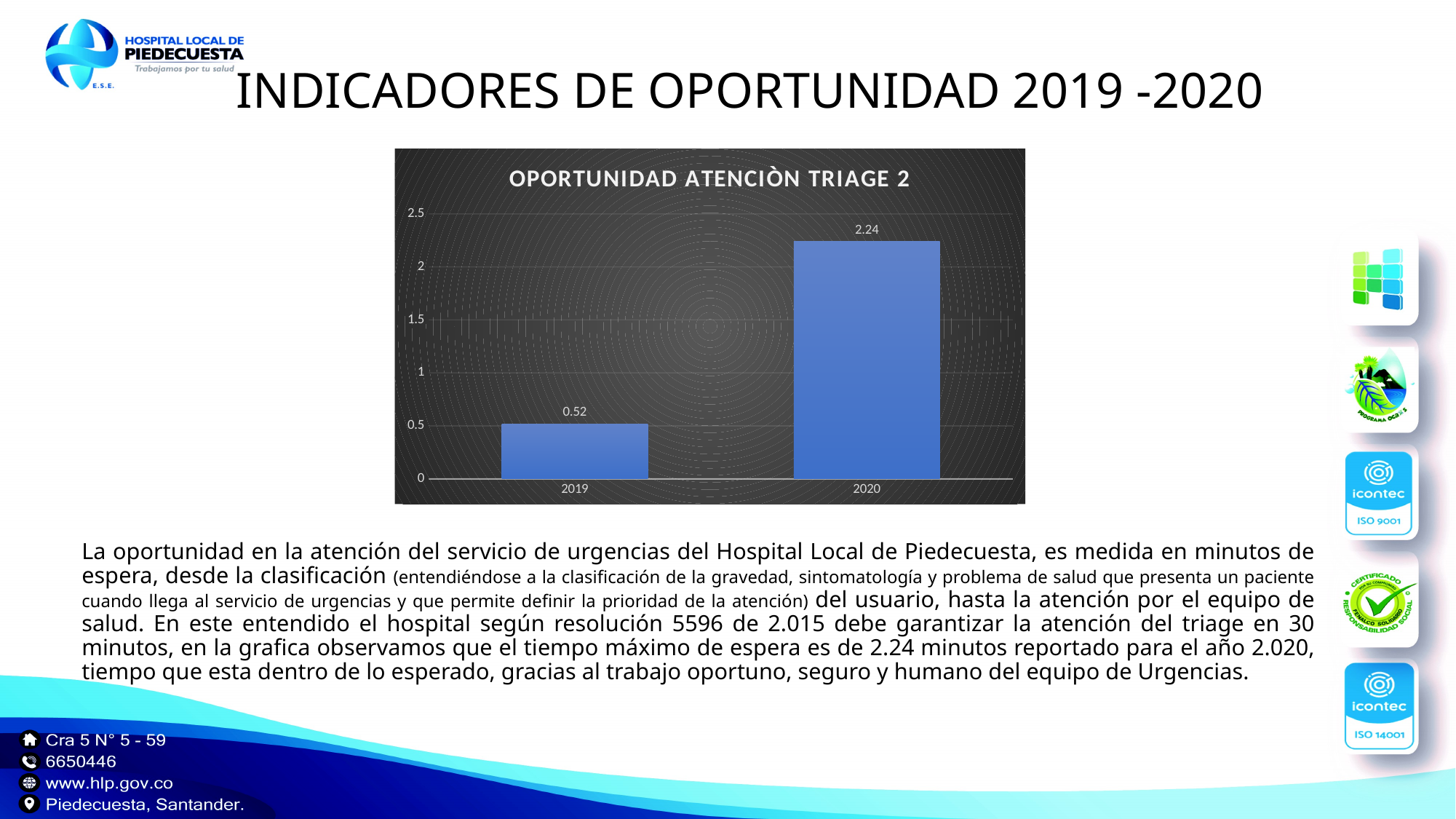
What is the value for 2020? 2.24 What kind of chart is shown? bar chart Which year has the lowest value? 2019 How many categories are shown on the x axis? 2 What is the value for 2019? 0.52 What is the title of the chart? OPORTUNIDAD ATENCIÒN TRIAGE 2 Is the value for 2019 greater or less than 1? less Which is larger, the value for 2019 or the value for 2020? 2020 Which year has the highest value? 2020 Is the value for 2020 greater or less than 2? greater What is the difference between the values for 2020 and 2019? 1.72 Do the values rise or fall from 2019 to 2020? rise